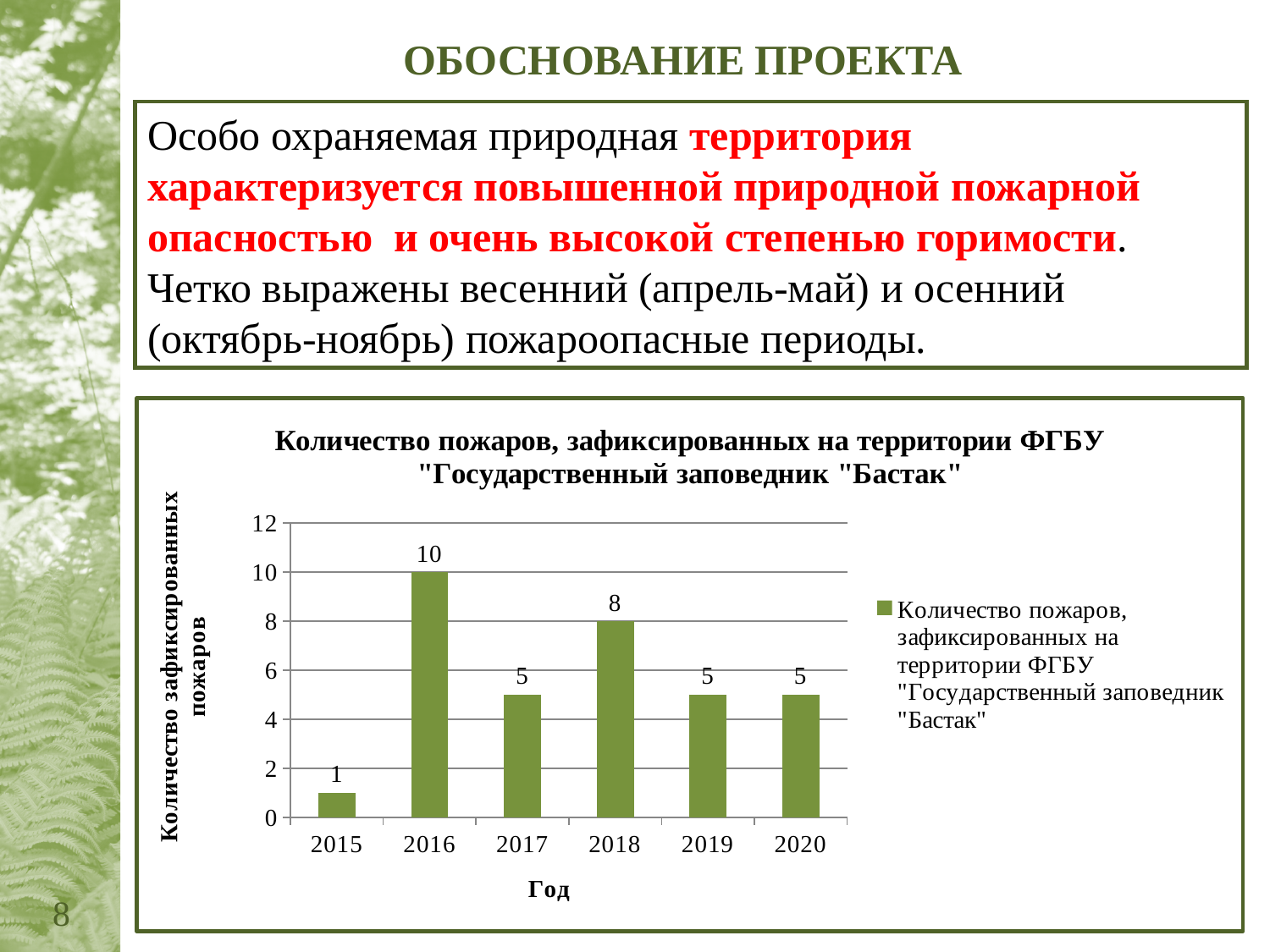
How many fires were recorded in 2016? 10 What is the x-axis title of the chart? Год How many fires were recorded in 2015? 1 Is the value for 2016 greater or less than 8? greater What is the value for 2018? 8 What kind of chart is shown on the slide? bar chart How many years are shown on the x axis? 6 Which is larger, the value for 2017 or the value for 2018? 2018 What is the difference between the values for 2016 and 2015? 9 Which year has the highest number of fires? 2016 Which year has the lowest number of fires? 2015 What is the difference between the values for 2016 and 2018? 2